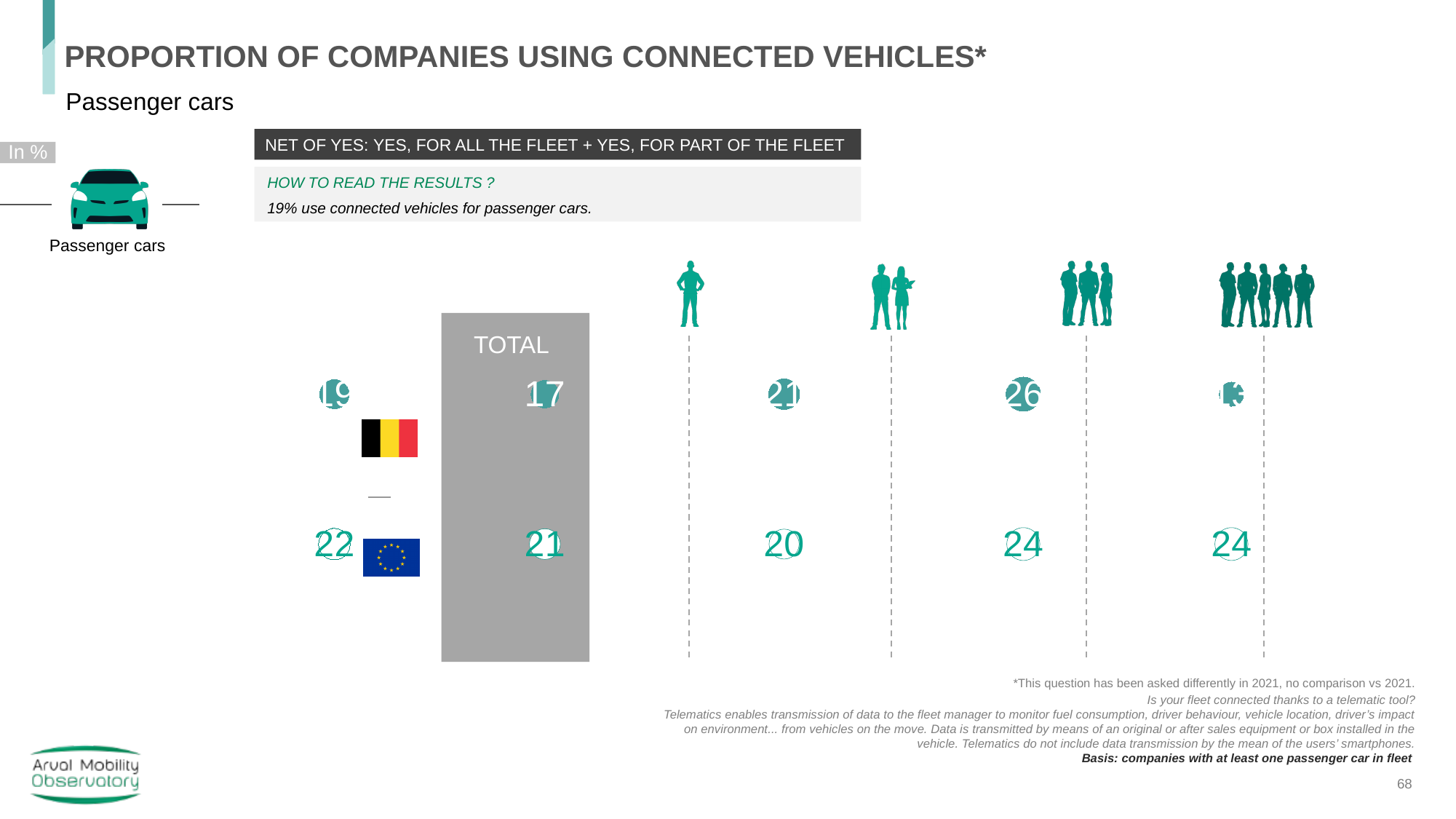
In what unit are the values on this slide expressed, according to the label at the top left? In % What is the difference between the value next to the EU flag and the value next to the Belgian flag? 3 In the grey TOTAL column, what is the value in the Belgium row? 17 What is the difference between the Europe and Belgium values in the TOTAL column? 4 In the TOTAL column, which row has the larger value, Belgium or Europe? Europe What is the value shown next to the Belgian flag? 19 In the grey TOTAL column, what is the value in the Europe (EU flag) row? 21 What is the value shown next to the EU flag? 22